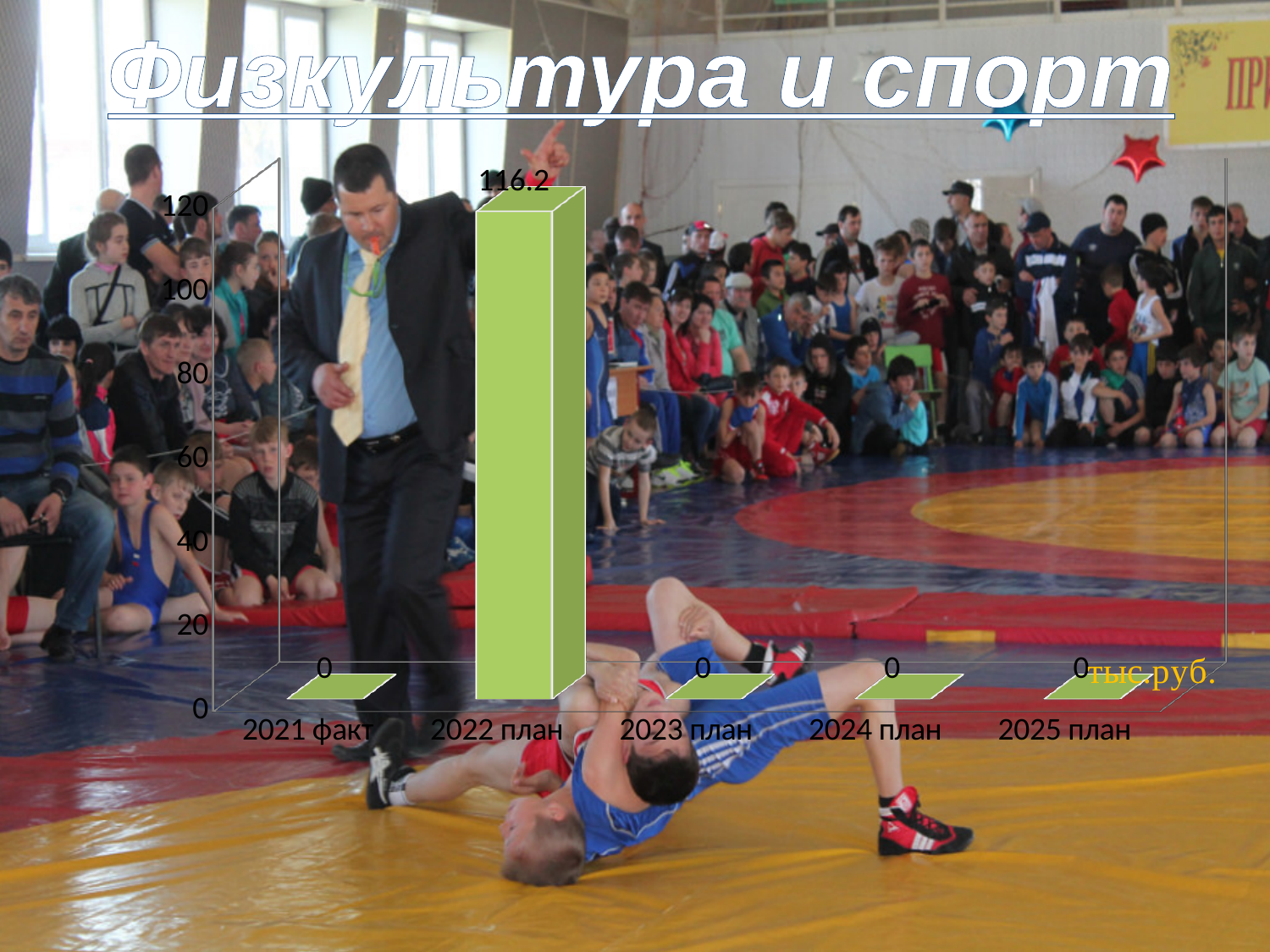
What is the value for 2025 план? 0 Which category has the highest value? 2022 план How many categories have a value of 0? 4 What kind of chart is shown on the slide? bar chart What is the value for 2021 факт? 0 How many categories are shown on the x axis? 5 What unit label is shown next to the chart? тыс.руб. Is the value for 2022 план greater or less than 100? greater What is the difference between the values for 2022 план and 2023 план? 116.2 What is the value for 2022 план? 116.2 Which is larger, the value for 2022 план or the value for 2024 план? 2022 план What is the highest value shown on the vertical axis? 120